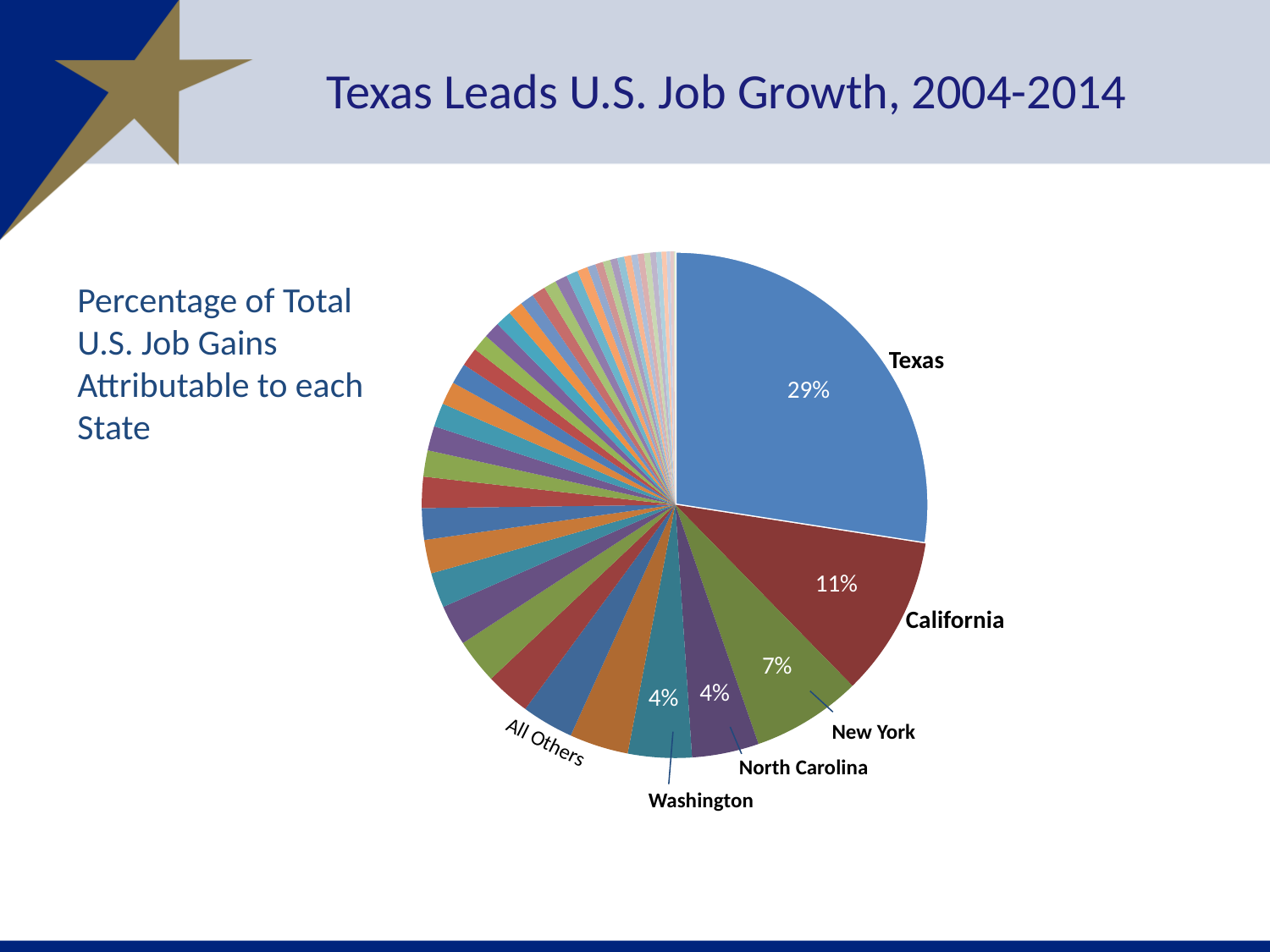
What is the title of the slide containing the pie chart? Texas Leads U.S. Job Growth, 2004-2014 How many percentage points larger is New York's share than North Carolina's share? 3 percentage points How many percentage points larger is Texas's share than California's share? 18 percentage points Which state has the largest share of U.S. job gains in the pie chart? Texas What kind of chart is shown on the slide? Pie chart How many states are labeled by name on the pie chart? 5 What percentage of total U.S. job gains is attributed to North Carolina? 4% What percentage of total U.S. job gains is attributed to New York? 7% What percentage of total U.S. job gains is attributed to Texas? 29% What percentage of total U.S. job gains is attributed to Washington? 4% What percentage of total U.S. job gains is attributed to California? 11% Which has a larger share of U.S. job gains, California or New York? California